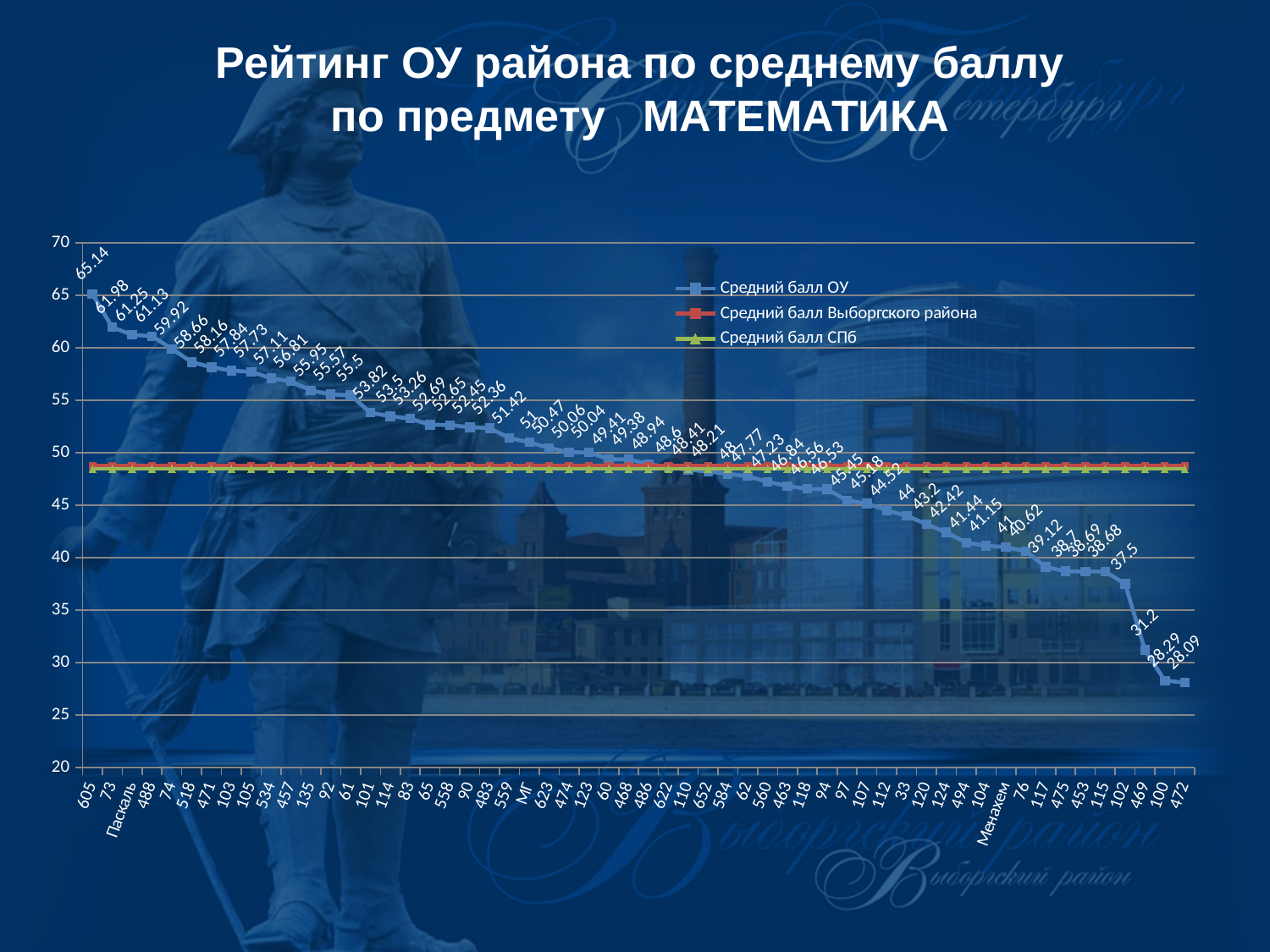
Which has a larger Средний балл ОУ, school 73 or school 469? 73 What is the difference between the Средний балл ОУ of school 605 and school 472? 37.05 What is the value of Средний балл ОУ for school 605? 65.14 Which school has the lowest Средний балл ОУ? 472 What is the value of Средний балл ОУ for school 100? 28.29 What kind of chart is shown on the slide? line chart Is the Средний балл ОУ value for Менахем greater or less than 45? less How many series does the legend list? 3 Which school has the highest Средний балл ОУ? 605 Do the Средний балл ОУ values rise or fall from left to right along the x axis? fall What is the value of Средний балл ОУ for school 472? 28.09 Which subject is named in the chart title? МАТЕМАТИКА